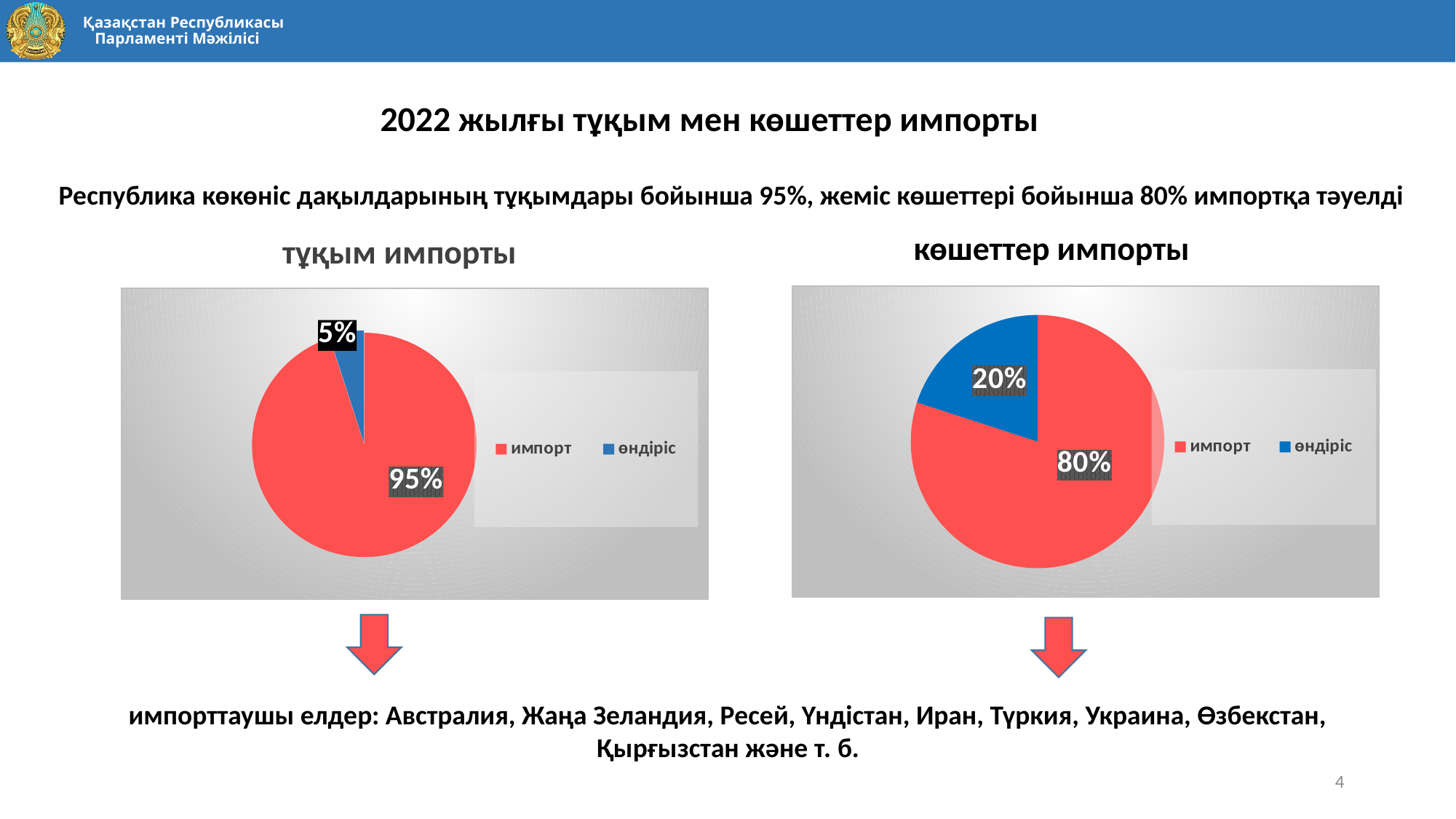
In the 'тұқым импорты' chart, what share does 'өндіріс' have? 5% In the 'көшеттер импорты' chart, what is the difference between the 'импорт' and 'өндіріс' shares? 60% In the 'тұқым импорты' chart, what colour is the 'өндіріс' slice? blue How many slices does the 'көшеттер импорты' chart have? 2 In the 'көшеттер импорты' chart, what share does 'өндіріс' have? 20% Is the 'өндіріс' share larger in the 'тұқым импорты' chart or the 'көшеттер импорты' chart? көшеттер импорты In the 'тұқым импорты' chart, which slice is the largest? импорт What type of chart is the 'тұқым импорты' chart? pie chart In the 'көшеттер импорты' chart, what share does 'импорт' have? 80% In the 'тұқым импорты' chart, what is the difference between the 'импорт' and 'өндіріс' shares? 90% In the 'көшеттер импорты' chart, which slice is the smallest? өндіріс In the 'тұқым импорты' chart, what share does 'импорт' have? 95%